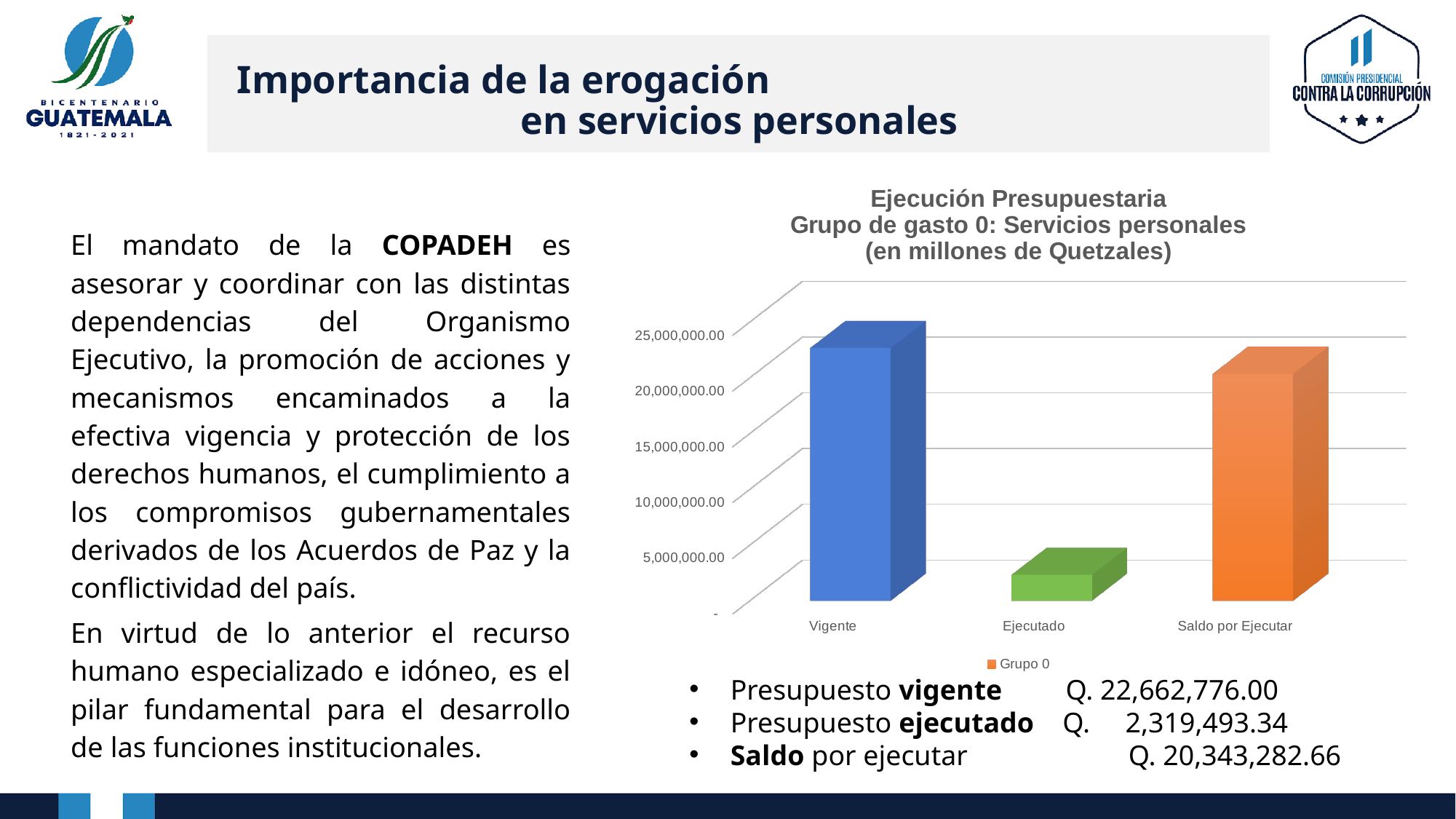
What is the name of the series in the chart legend? Grupo 0 How many series does the chart legend list? 1 Is the value for Vigente greater or less than 20,000,000.00? greater What type of chart is shown on the slide? Bar chart How many categories are shown on the x axis of the chart? 3 According to the slide, what is the value of the Presupuesto vigente? Q. 22,662,776.00 Is the value for Saldo por Ejecutar greater or less than 15,000,000.00? greater According to the slide, what is the value of the Presupuesto ejecutado? Q. 2,319,493.34 Which category has the highest bar in the chart? Vigente Which is larger, the bar for Vigente or the bar for Saldo por Ejecutar? Vigente Which category has the lowest bar in the chart? Ejecutado Is the value for Ejecutado greater or less than 5,000,000.00? less